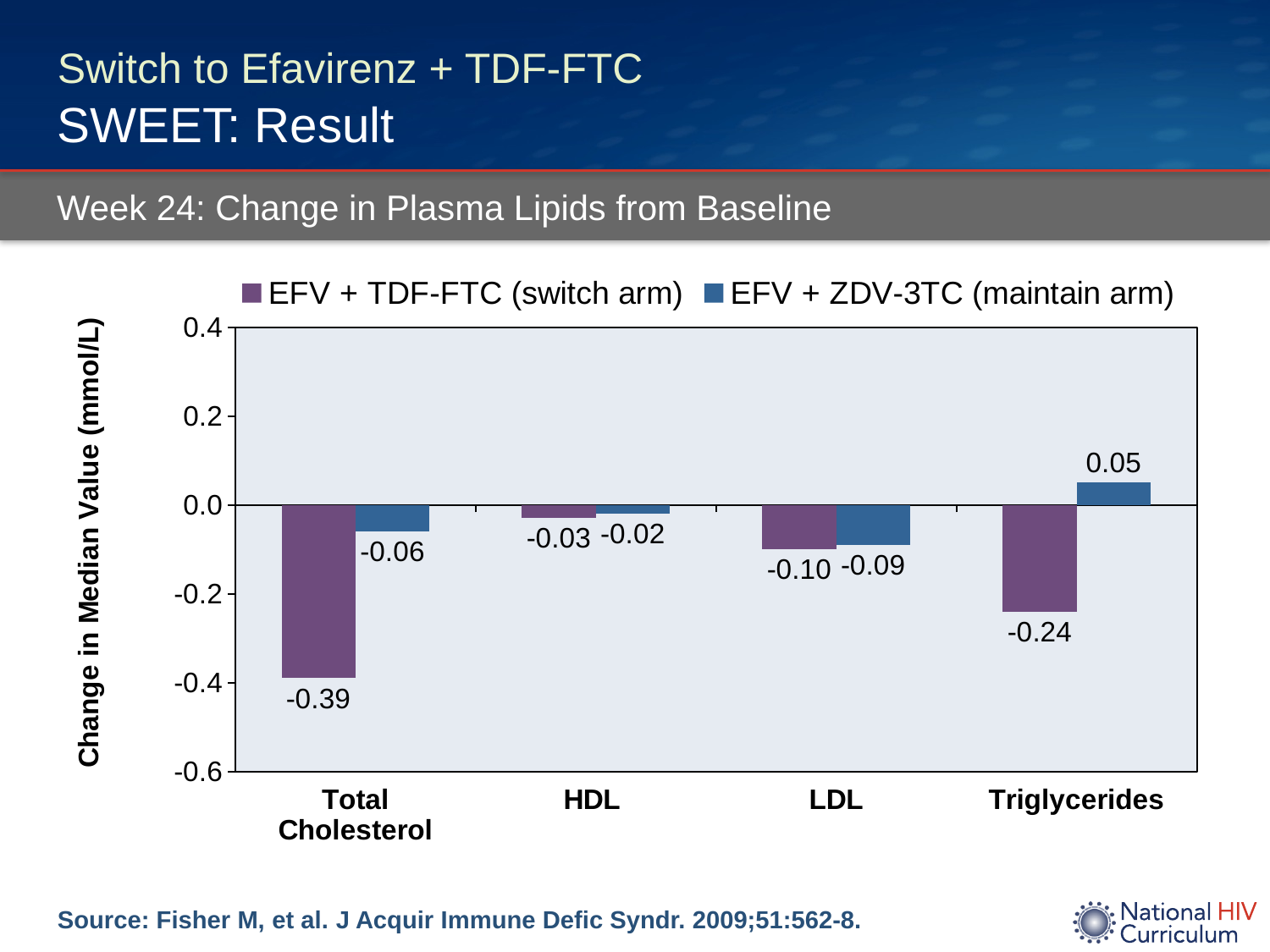
How many lipid categories are shown on the x axis? 4 For Triglycerides, which arm has the larger (higher) change in median value? EFV + ZDV-3TC (maintain arm) Which lipid category has the highest value in the EFV + ZDV-3TC (maintain arm)? Triglycerides What is the difference between the switch arm and maintain arm values for Total Cholesterol? 0.33 What is the difference between the switch arm and maintain arm values for Triglycerides? 0.29 What type of chart is shown on the slide? Bar chart What is the change in median value for HDL in the EFV + ZDV-3TC (maintain arm)? -0.02 What is the change in median value for Triglycerides in the EFV + ZDV-3TC (maintain arm)? 0.05 What is the change in median value for LDL in the EFV + TDF-FTC (switch arm)? -0.10 How many series does the legend list? 2 Which lipid category shows the largest decrease in the EFV + TDF-FTC (switch arm)? Total Cholesterol What is the change in median value for Total Cholesterol in the EFV + TDF-FTC (switch arm)? -0.39